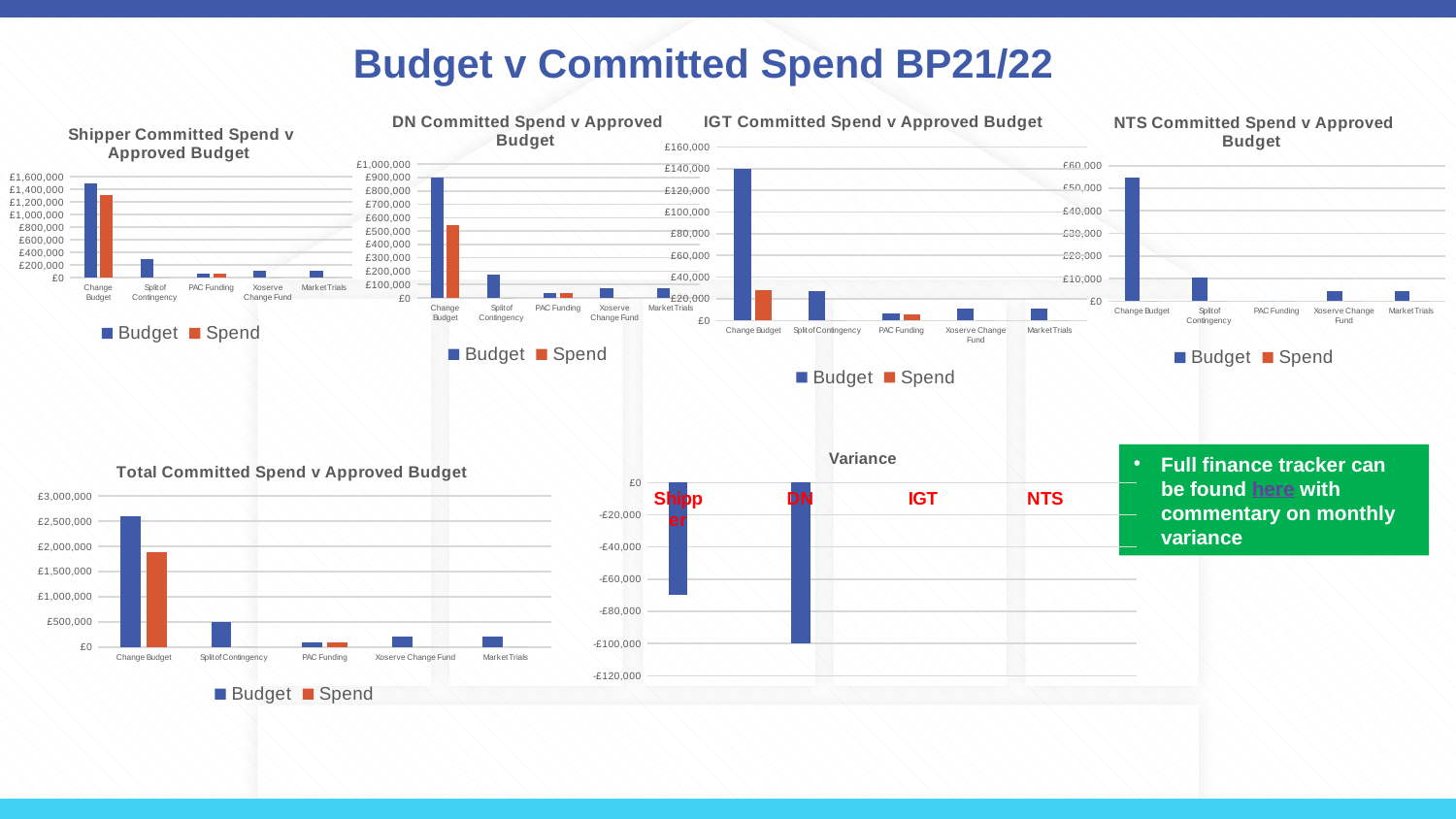
In the 'Total Committed Spend v Approved Budget' chart, which category has the highest Budget value? Change Budget How many categories are shown on the x axis of the 'Variance' chart? 4 How many series does the legend of the 'Shipper Committed Spend v Approved Budget' chart list? 2 What kind of chart is the 'Total Committed Spend v Approved Budget' chart? bar chart In the 'DN Committed Spend v Approved Budget' chart, is the Budget value for Change Budget greater or less than £800,000? greater In the 'Variance' chart, which category has the lowest (most negative) value? DN In the 'Total Committed Spend v Approved Budget' chart, is the Spend value for Change Budget greater or less than £2,000,000? less In the 'IGT Committed Spend v Approved Budget' chart, is the Budget value for Change Budget greater or less than £120,000? greater How many categories are shown on the x axis of the 'Total Committed Spend v Approved Budget' chart? 5 In the 'Shipper Committed Spend v Approved Budget' chart, which is larger for Change Budget: Budget or Spend? Budget